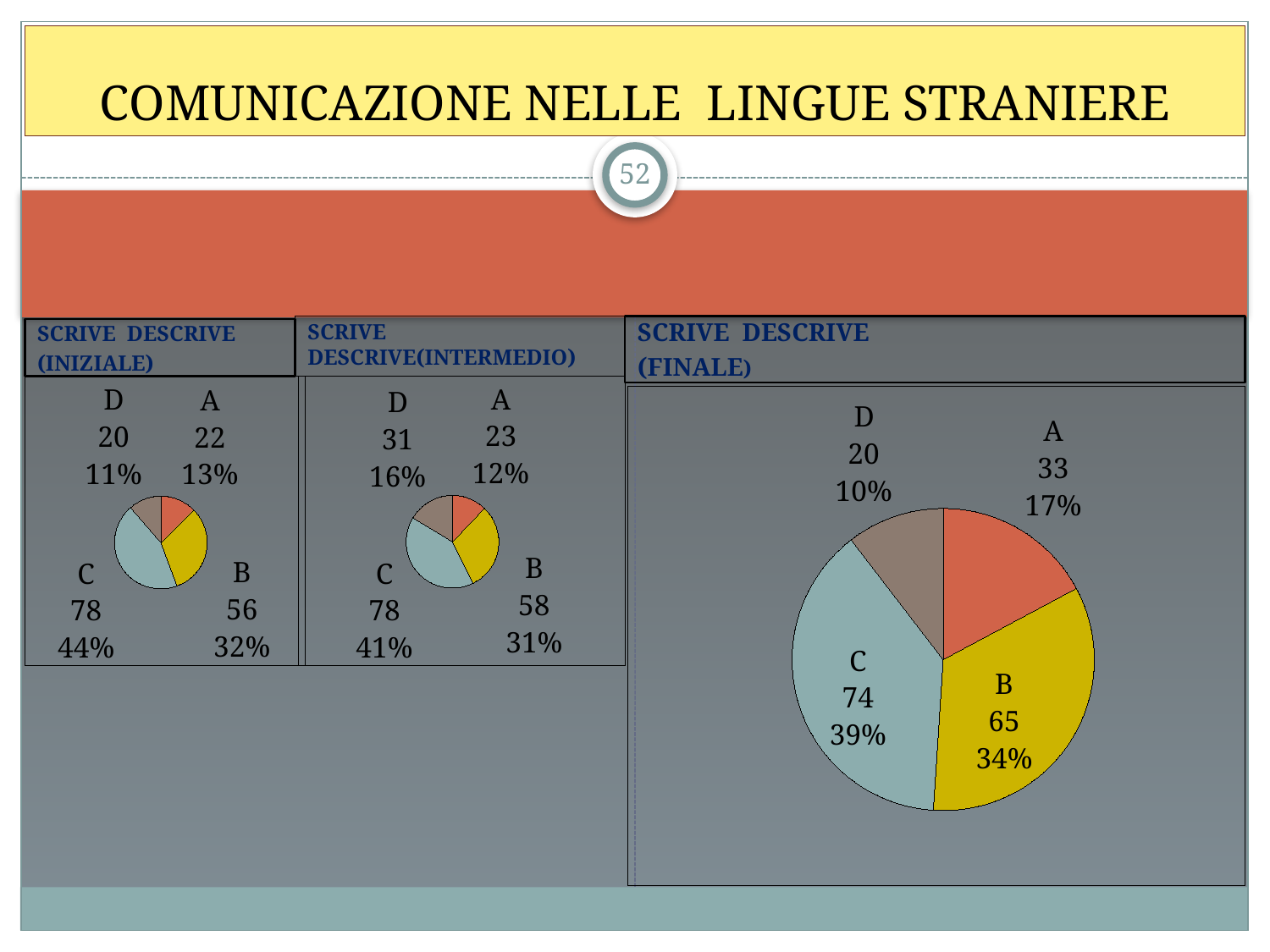
What kind of chart is the SCRIVE DESCRIVE (FINALE) chart? Pie chart How many pie charts are shown on the slide? 3 In the SCRIVE DESCRIVE(INTERMEDIO) chart, which category has the smallest value? A In the SCRIVE DESCRIVE (FINALE) chart, what percentage share does category C have? 39% In the SCRIVE DESCRIVE (FINALE) chart, what is the difference between the values for C and B? 9 In the SCRIVE DESCRIVE(INTERMEDIO) chart, what percentage share does category D have? 16% In the SCRIVE DESCRIVE (INIZIALE) chart, what is the value for category D? 20 In the SCRIVE DESCRIVE (FINALE) chart, what is the value for category B? 65 In the SCRIVE DESCRIVE (INIZIALE) chart, which is larger, the value for B or the value for A? B In the SCRIVE DESCRIVE (FINALE) chart, which category has the largest value? C How many categories does the SCRIVE DESCRIVE (FINALE) chart show? 4 In the SCRIVE DESCRIVE(INTERMEDIO) chart, what is the value for category A? 23